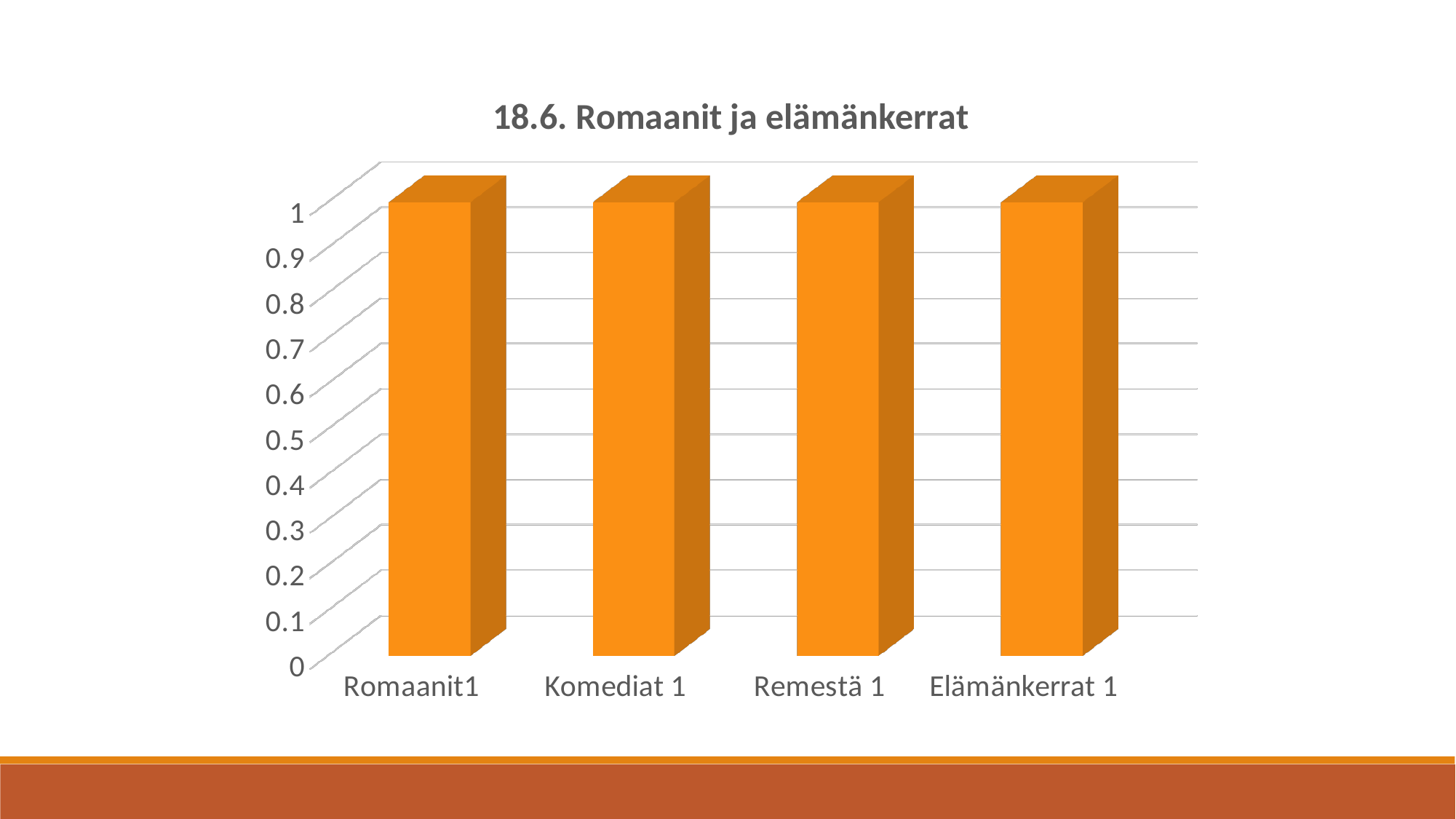
What colour are the bars in the chart? orange What is the value for Remestä 1? 1 Do the values rise, fall, or stay the same across the categories from left to right? stay the same Is the value for Remestä 1 greater or less than 0.5? greater How many categories are shown on the x axis? 4 What is the difference between the values for Romaanit1 and Komediat 1? 0 Is the value for Elämänkerrat 1 greater or less than 0.8? greater What is the value for Elämänkerrat 1? 1 What is the title of the chart? 18.6. Romaanit ja elämänkerrat What is the value for Romaanit1? 1 What kind of chart is shown on the slide? bar chart What is the value for Komediat 1? 1